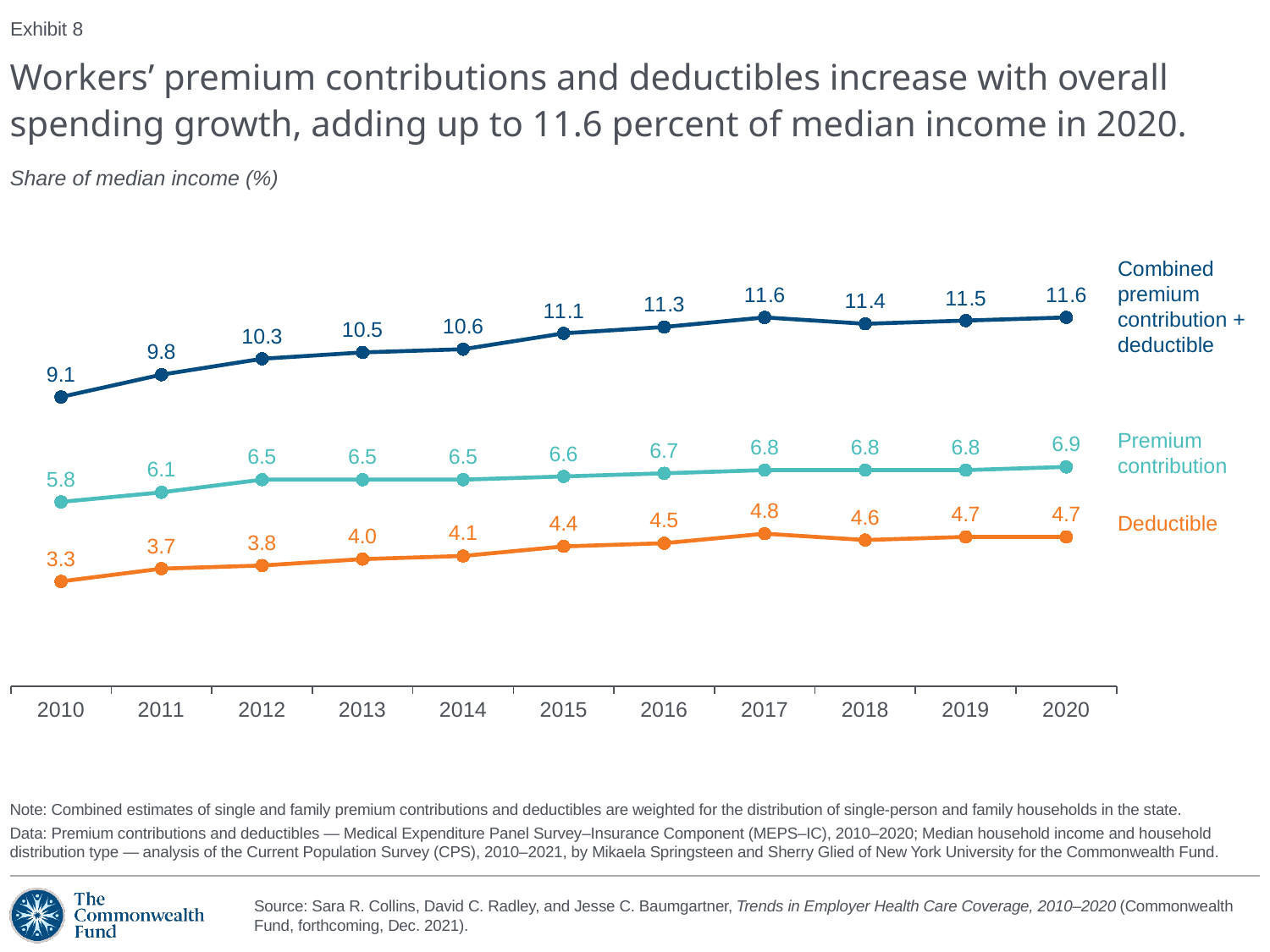
By how much did the combined premium contribution + deductible share increase from 2010 to 2020? 2.5 In which year was the combined premium contribution + deductible share lowest? 2010 What kind of chart is shown on the slide? Line chart What is the difference between the premium contribution and the deductible in 2020? 2.2 Does the premium contribution share generally rise or fall from 2010 to 2020? Rise What was the deductible share of median income in 2020? 4.7 What was the premium contribution share of median income in 2016? 6.7 What was the combined premium contribution + deductible share of median income in 2010? 9.1 In which year was the deductible share of median income highest? 2017 How many years are shown on the x axis? 11 Which was larger in 2015, the premium contribution or the deductible? Premium contribution How many series are plotted on the chart? 3